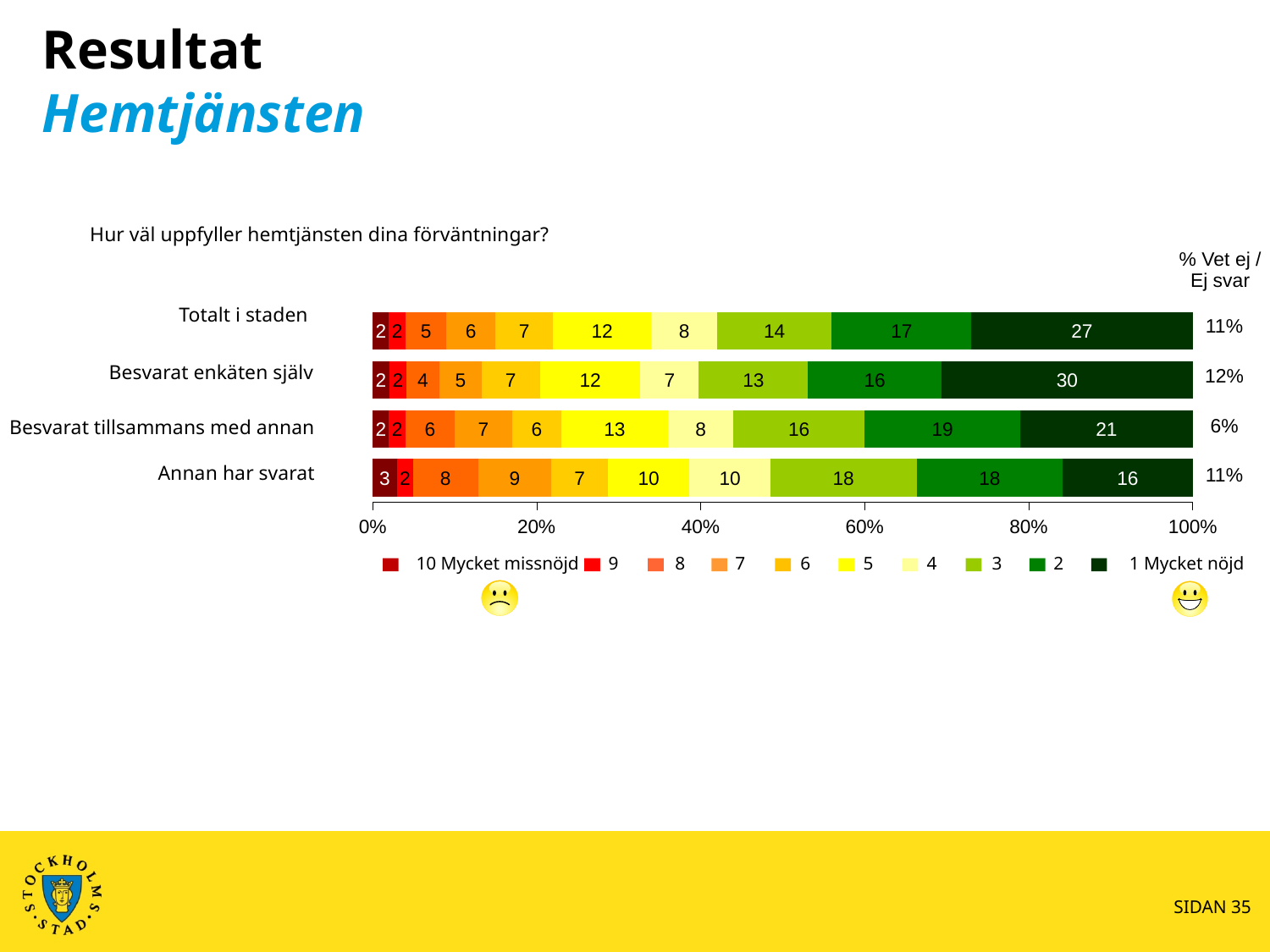
What kind of chart is shown on the slide? Stacked bar chart What is the total of the stacked bar for 'Totalt i staden'? 100 What is the difference between the '1 Mycket nöjd' values for 'Besvarat enkäten själv' and 'Annan har svarat'? 14 Which has the larger value for series '2': 'Besvarat tillsammans med annan' or 'Totalt i staden'? Besvarat tillsammans med annan How many series does the legend list? 10 What is the value of '10 Mycket missnöjd' for 'Annan har svarat'? 3 What question is the chart about, as written above it? Hur väl uppfyller hemtjänsten dina förväntningar? Which category has the lowest value for '1 Mycket nöjd'? Annan har svarat How many categories (rows) does the chart show? 4 What is the '% Vet ej / Ej svar' value for 'Besvarat tillsammans med annan'? 6% What is the value of '1 Mycket nöjd' for 'Besvarat enkäten själv'? 30 Which category has the highest value for '1 Mycket nöjd'? Besvarat enkäten själv